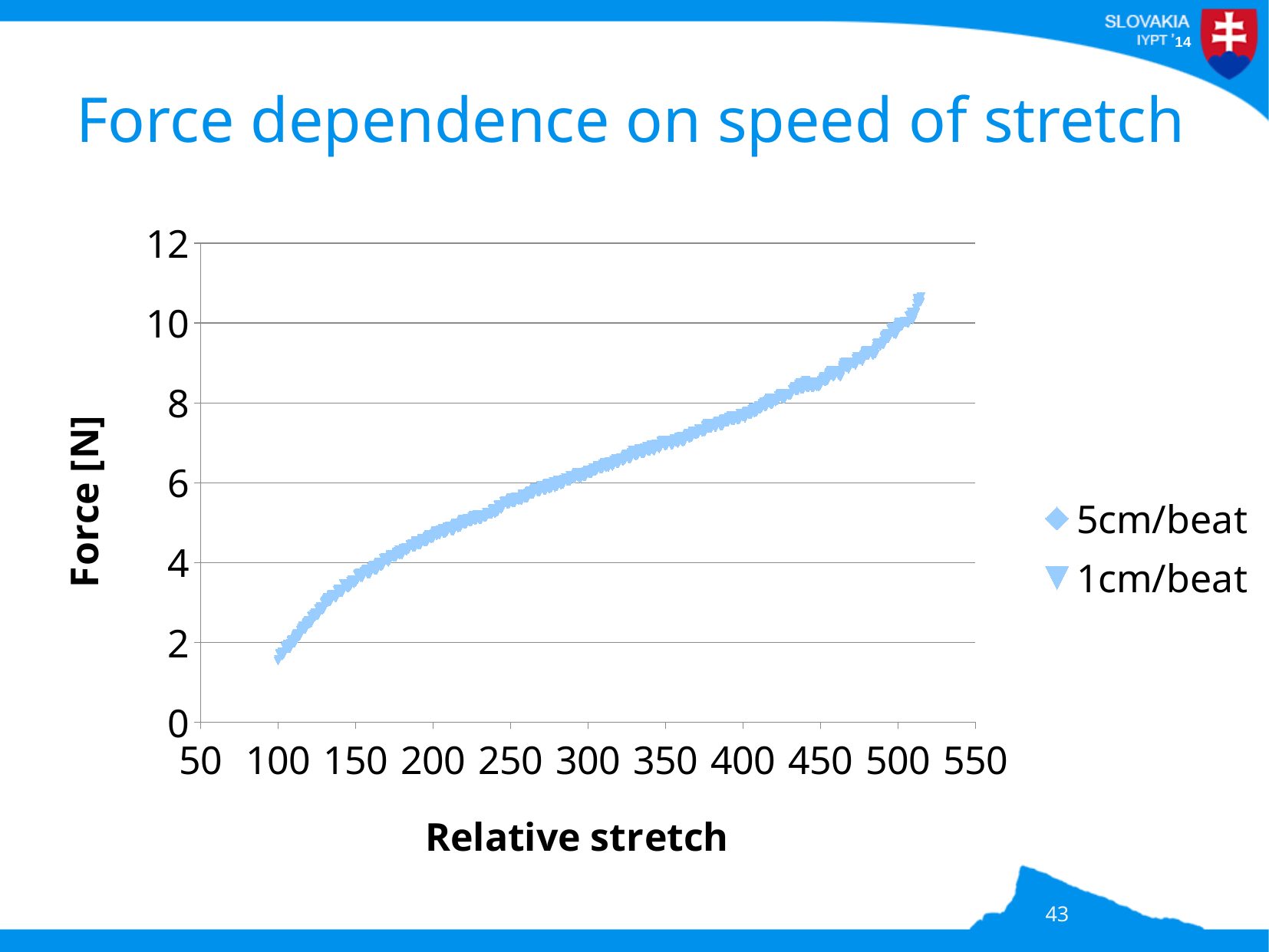
Is the force at a relative stretch of 100 greater or less than 4 N? less Is the force at a relative stretch of 200 greater or less than 8 N? less Is the force at a relative stretch of 500 greater or less than 8 N? greater Does the force rise or fall as relative stretch increases along the x axis? rise What are the two series named in the legend? 5cm/beat and 1cm/beat What kind of chart is shown on the slide? scatter chart How many series does the legend list? 2 What is the title of the chart? Force dependence on speed of stretch